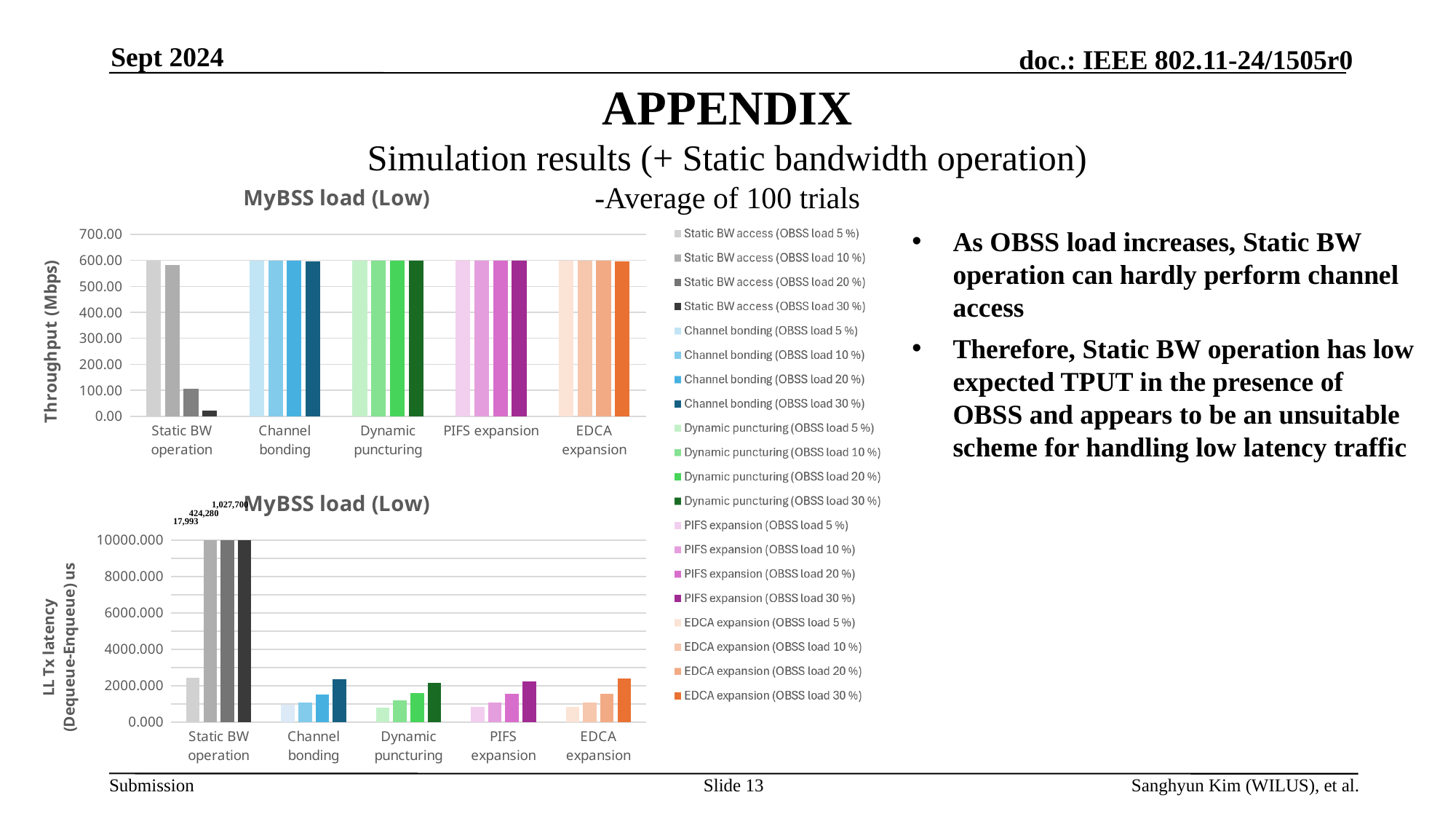
What is the y-axis label of the top chart? Throughput (Mbps) What type of chart is the top chart on the slide? bar chart How many categories are shown on the x axis of the top chart (Throughput)? 5 In the bottom chart (LL Tx latency), what is the labelled value for Static BW operation at OBSS load 20 %? 424,280 In the bottom chart (LL Tx latency), is the value for Dynamic puncturing at OBSS load 5 % greater or less than 1000.000? less In the bottom chart (LL Tx latency), what is the labelled value for Static BW operation at OBSS load 30 %? 1,027,700 How many series does the legend list? 20 In the top chart (Throughput), is the value for Static BW operation at OBSS load 30 % greater or less than 100.00? less In the bottom chart (LL Tx latency), which is larger at OBSS load 5 %: Static BW operation or Channel bonding? Static BW operation In the top chart (Throughput), is the value for Channel bonding at OBSS load 5 % greater or less than 500.00? greater In the top chart (Throughput), which category has the lowest throughput at OBSS load 30 %? Static BW operation In the bottom chart (LL Tx latency), what is the labelled value for Static BW operation at OBSS load 10 %? 17,993